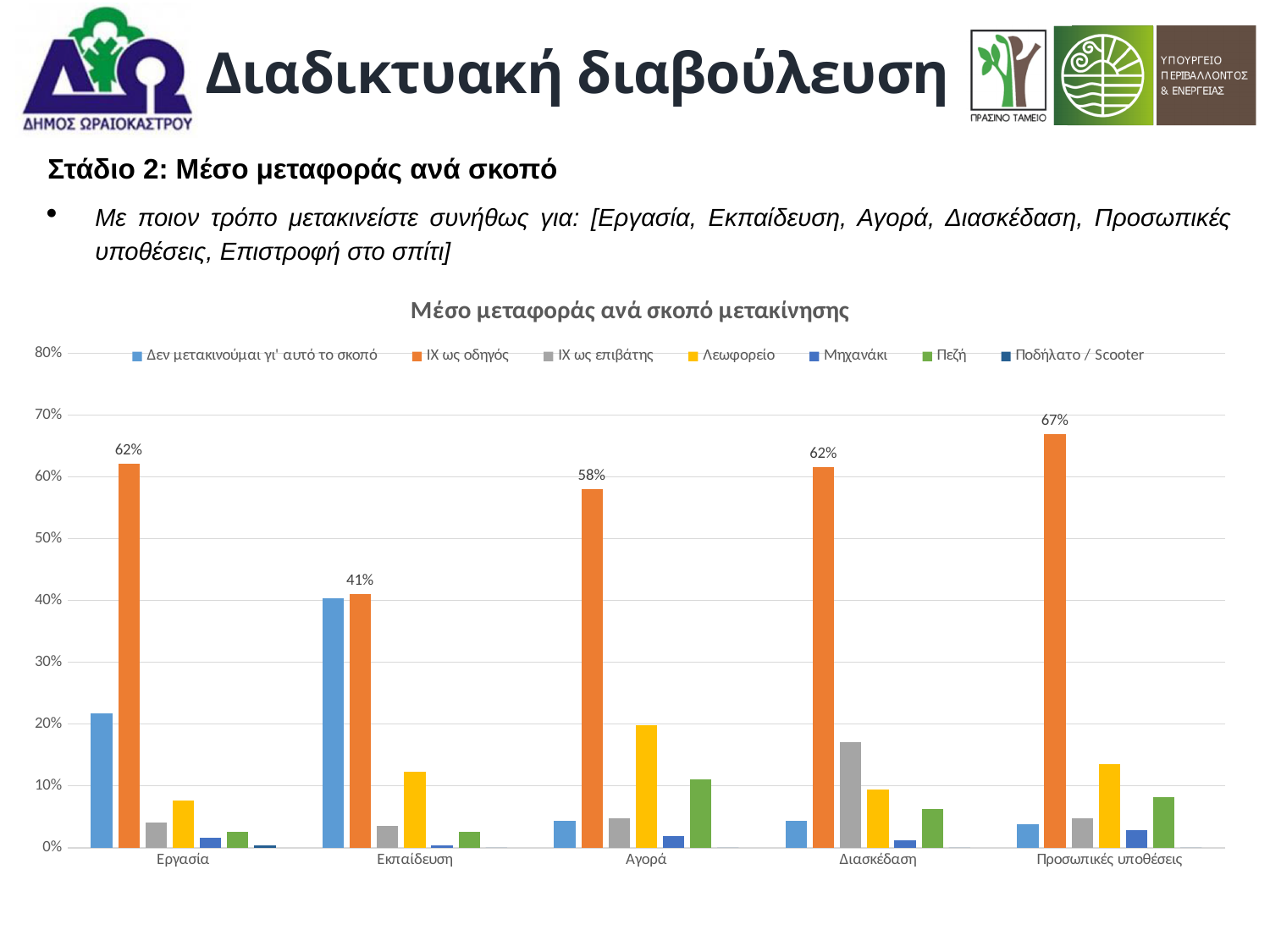
Which category has the larger ΙΧ ως οδηγός value, Αγορά or Εκπαίδευση? Αγορά What is the difference between the ΙΧ ως οδηγός values for Προσωπικές υποθέσεις and Εκπαίδευση? 26 percentage points What is the value for ΙΧ ως οδηγός in the Εργασία category? 62% What is the value for ΙΧ ως οδηγός in the Προσωπικές υποθέσεις category? 67% How many categories are shown on the x axis of the chart? 5 In which category is the ΙΧ ως οδηγός value highest? Προσωπικές υποθέσεις Is the value for Δεν μετακινούμαι γι' αυτό το σκοπό in the Εκπαίδευση category greater or less than 30%? greater What is the value for ΙΧ ως οδηγός in the Εκπαίδευση category? 41% Is the value for Λεωφορείο in the Αγορά category greater or less than 10%? greater What is the value for ΙΧ ως οδηγός in the Αγορά category? 58% How many series does the chart legend list? 7 In which category is the ΙΧ ως οδηγός value lowest? Εκπαίδευση